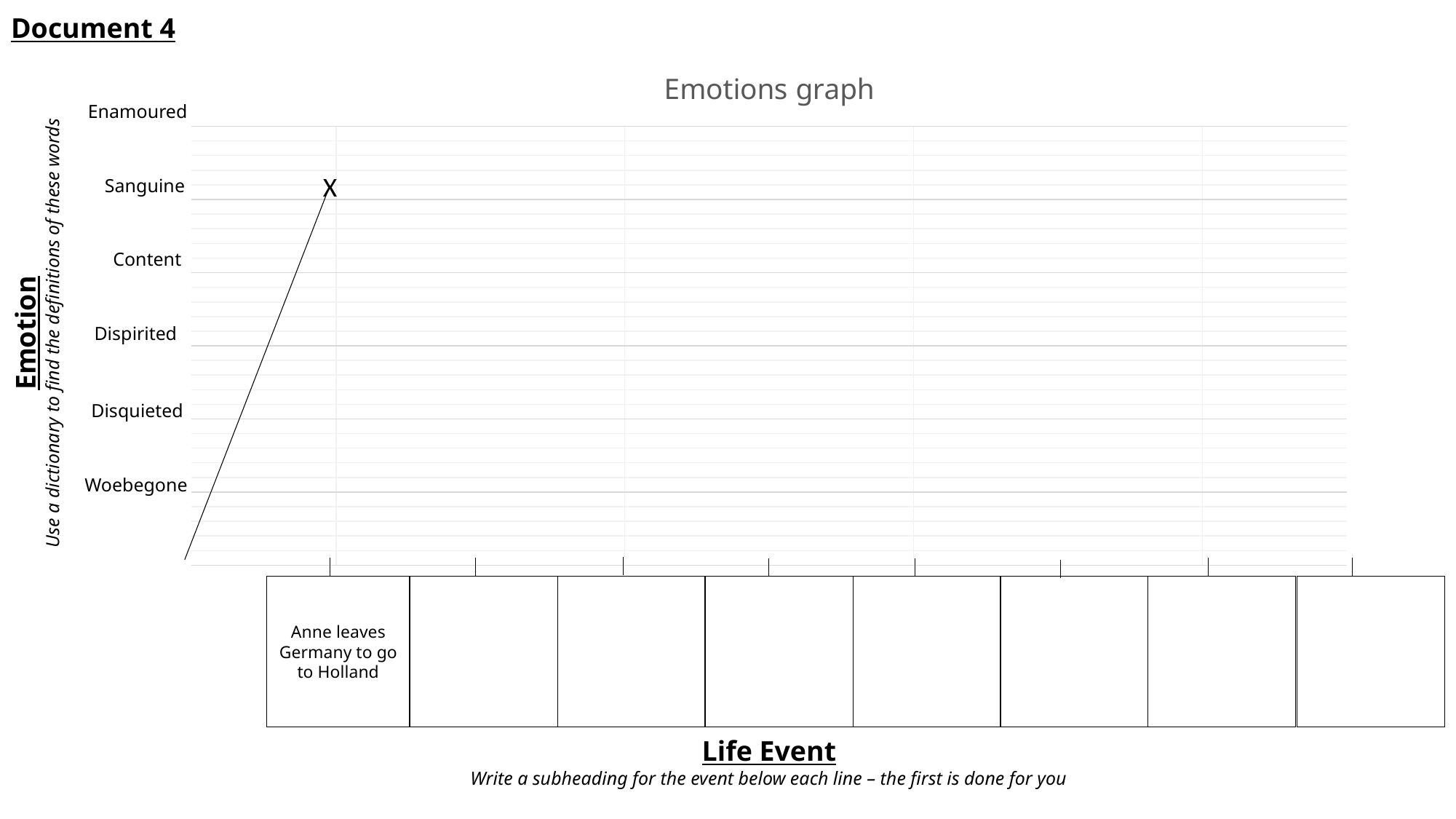
What emotion is plotted for the life event "Anne leaves Germany to go to Holland"? Sanguine How many emotion labels are listed on the vertical axis? 6 Which life event is the only one with a label filled in? Anne leaves Germany to go to Holland What kind of chart is this? line chart How many life event boxes are there along the horizontal axis? 8 Which emotion label is at the top of the vertical axis? Enamoured How many data points are plotted on the chart? 1 Which emotion label is at the bottom of the vertical axis? Woebegone What is the label of the horizontal axis? Life Event What is the title of the chart? Emotions graph